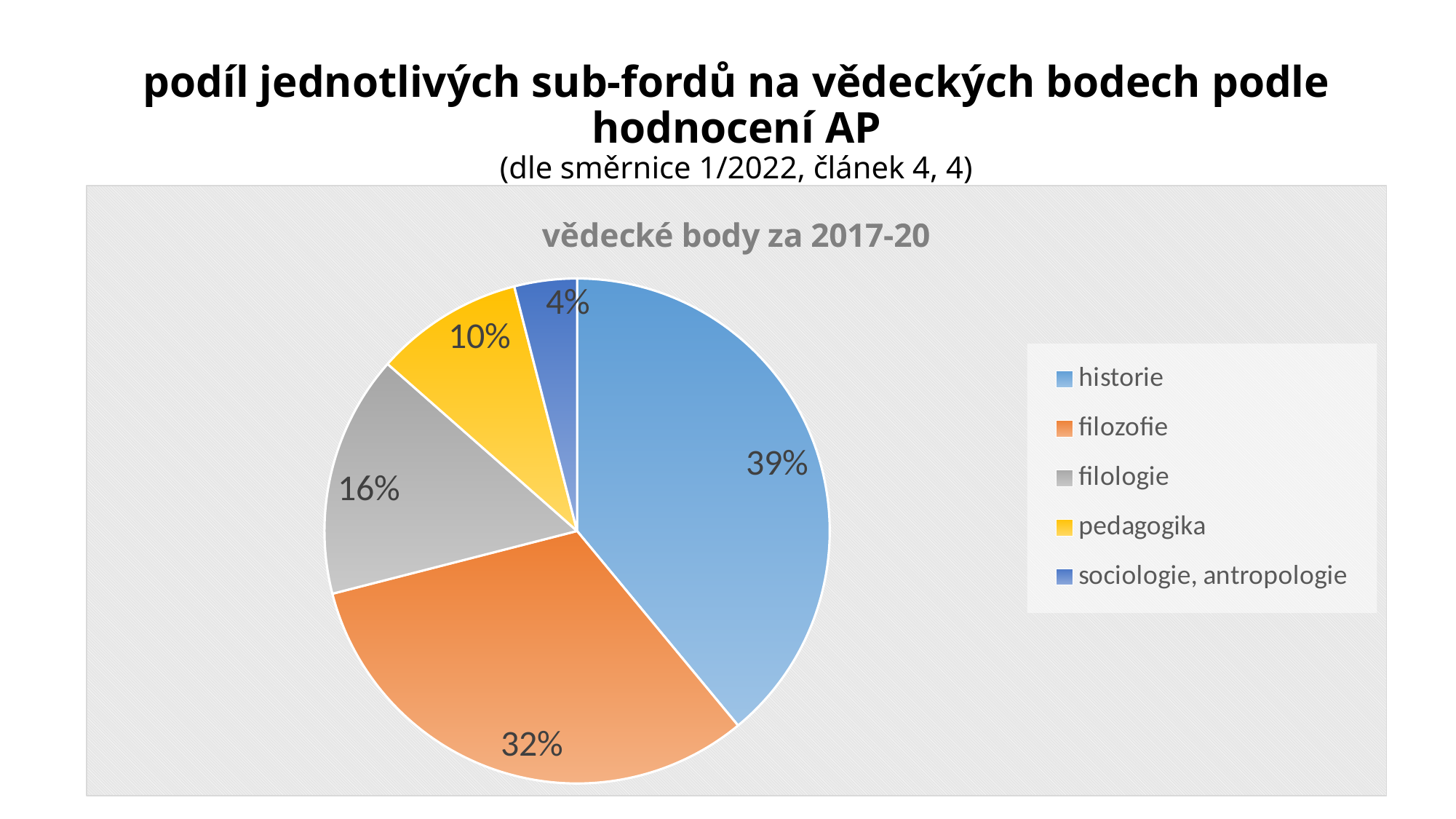
What is the chart's title? vědecké body za 2017-20 Which category has the smallest slice of the pie? sociologie, antropologie How many categories does the legend list? 5 Which is larger, the share for filologie or the share for pedagogika? filologie What share of the pie does historie have? 39% What share of the pie does sociologie, antropologie have? 4% What share of the pie does filozofie have? 32% Which category has the largest slice of the pie? historie What kind of chart is shown on the slide? pie chart What share of the pie does pedagogika have? 10% What share of the pie does filologie have? 16% What is the difference in percentage points between historie and filozofie? 7